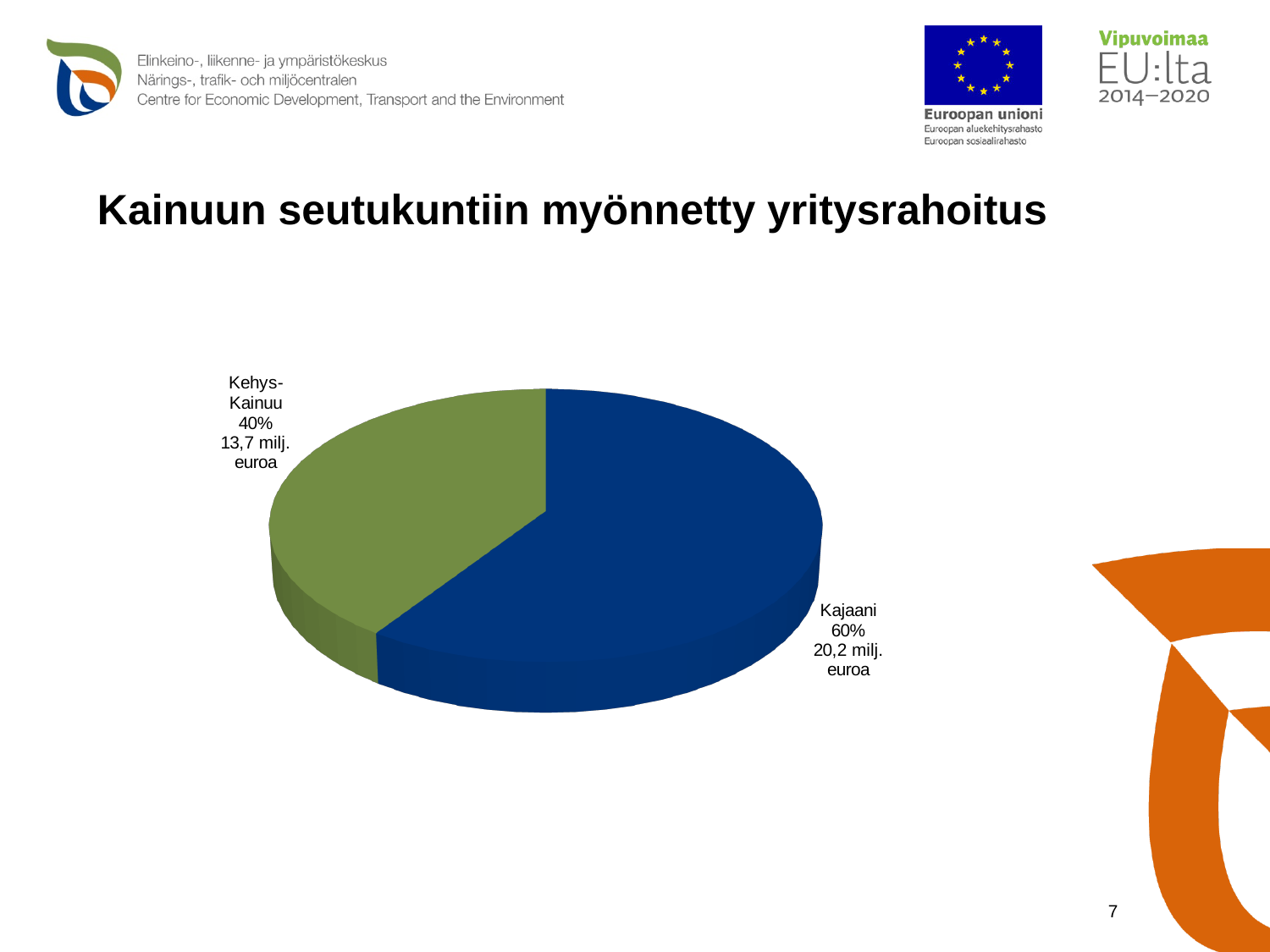
What is the value shown for Kajaani in million euros? 20,2 milj. euroa Which is larger, the value for Kajaani or the value for Kehys-Kainuu? Kajaani What is the value shown for Kehys-Kainuu in million euros? 13,7 milj. euroa What share of the pie does Kajaani represent? 60% What share of the pie does Kehys-Kainuu represent? 40% What is the difference in percentage points between the Kajaani and Kehys-Kainuu shares? 20 percentage points How many slices does the pie chart have? 2 Which slice is the smallest in the pie chart? Kehys-Kainuu What is the title of the chart on the slide? Kainuun seutukuntiin myönnetty yritysrahoitus What colour is the Kajaani slice of the pie chart? blue What kind of chart is shown on the slide? pie chart Which slice is the largest in the pie chart? Kajaani